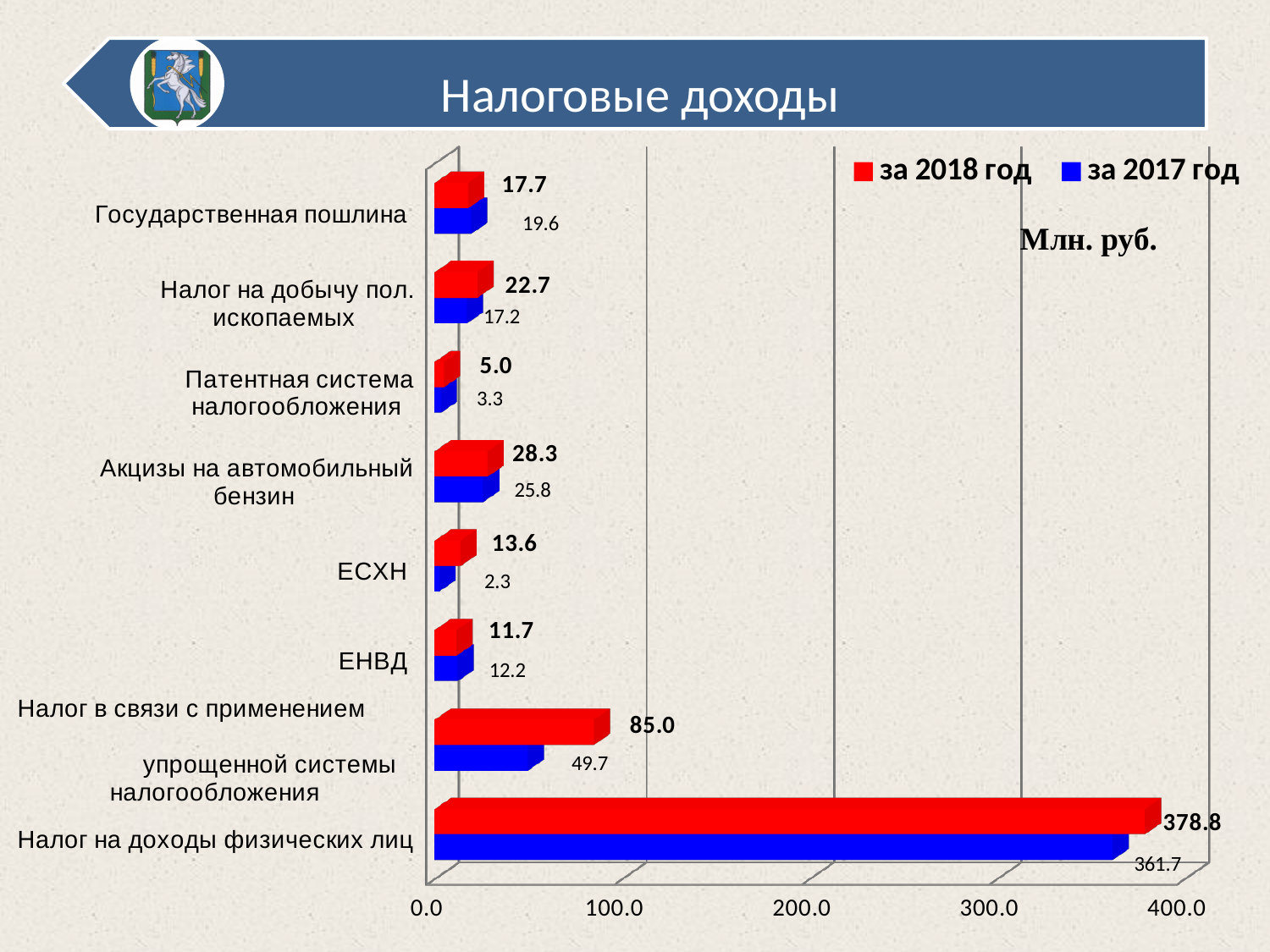
Is the value for Налог на доходы физических лиц in the series за 2017 год greater or less than 300.0? greater Which category has the highest value in the series за 2018 год? Налог на доходы физических лиц What kind of chart is shown on the slide? bar chart What is the difference between the за 2018 год and за 2017 год values for Налог в связи с применением упрощенной системы налогообложения? 35.3 How many series does the legend list? 2 Which category has the lowest value in the series за 2017 год? ЕСХН What is the value for ЕСХН in the series за 2017 год? 2.3 What is the value for Налог на доходы физических лиц in the series за 2018 год? 378.8 For ЕНВД, which series has the larger value: за 2018 год or за 2017 год? за 2017 год What is the value for Налог на доходы физических лиц in the series за 2017 год? 361.7 What is the value for Акцизы на автомобильный бензин in the series за 2018 год? 28.3 How many categories are shown on the chart? 8